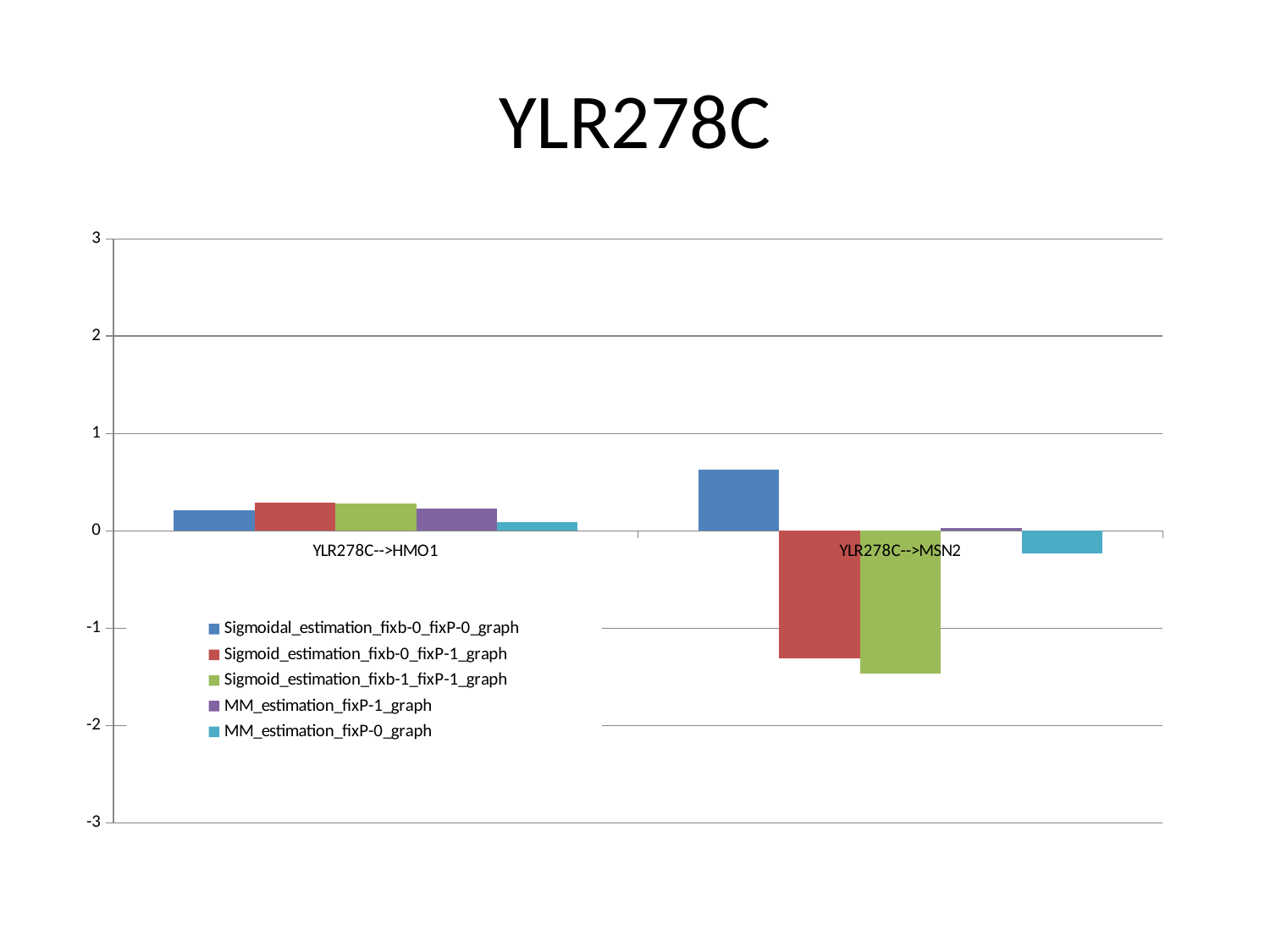
Which series has the lowest value for YLR278C-->HMO1? MM_estimation_fixP-0_graph Is the value of Sigmoid_estimation_fixb-0_fixP-1_graph for YLR278C-->MSN2 greater or less than -1? less Is the value of Sigmoidal_estimation_fixb-0_fixP-0_graph for YLR278C-->MSN2 greater or less than 1? less Which is larger: the value of Sigmoidal_estimation_fixb-0_fixP-0_graph for YLR278C-->HMO1 or for YLR278C-->MSN2? YLR278C-->MSN2 Which is larger: the value of Sigmoid_estimation_fixb-0_fixP-1_graph for YLR278C-->HMO1 or for YLR278C-->MSN2? YLR278C-->HMO1 What kind of chart is shown on the slide? bar chart How many series does the legend list? 5 Which series has the highest value for YLR278C-->MSN2? Sigmoidal_estimation_fixb-0_fixP-0_graph Is the value of Sigmoid_estimation_fixb-1_fixP-1_graph for YLR278C-->HMO1 greater or less than 1? less Which series has the lowest value for YLR278C-->MSN2? Sigmoid_estimation_fixb-1_fixP-1_graph What is the title of the chart? YLR278C How many categories are shown on the x axis? 2